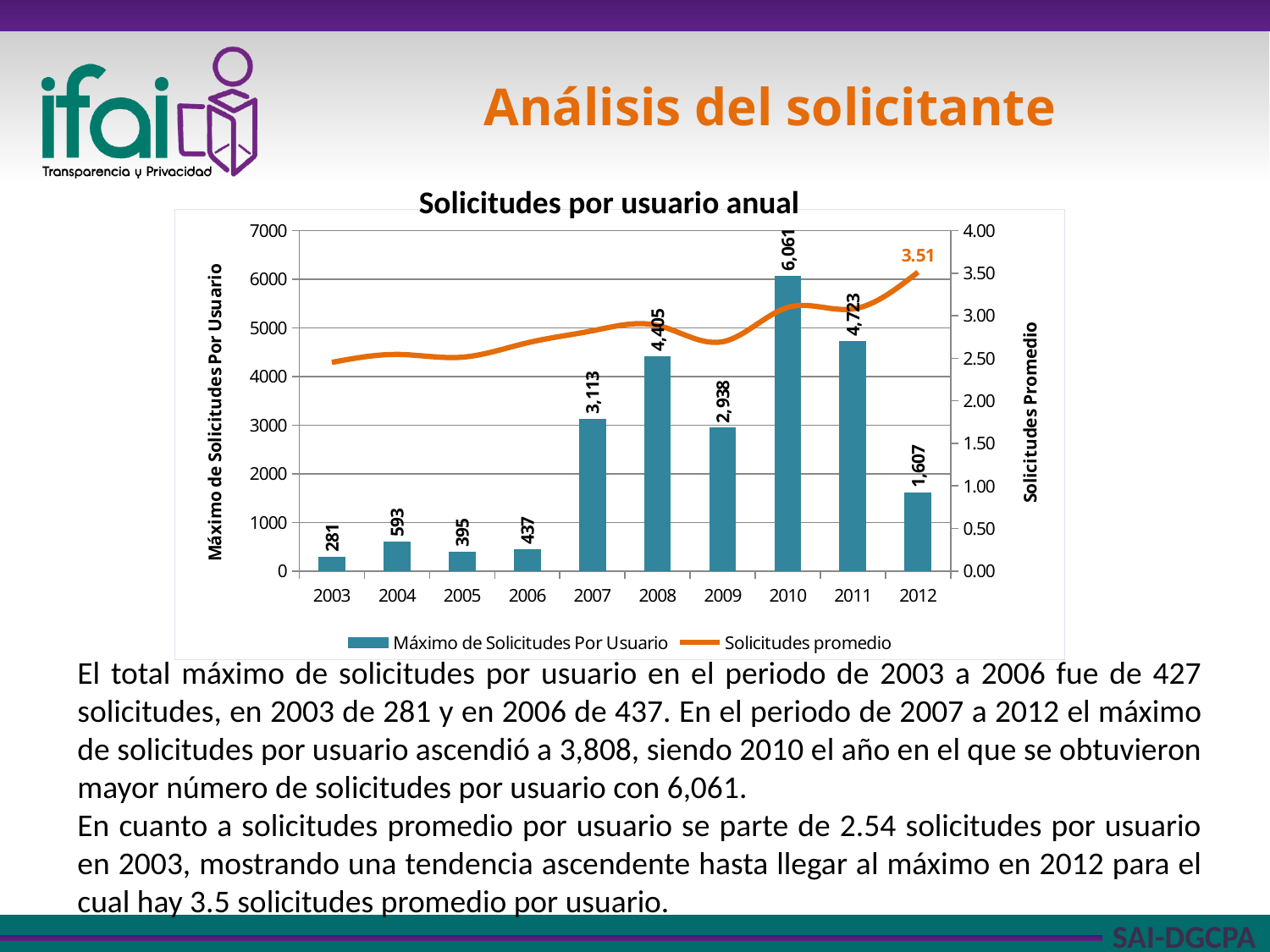
How many series does the chart legend list? 2 What is the value of Máximo de Solicitudes Por Usuario for 2010? 6,061 How many years are shown on the x axis of the chart? 10 What is the difference between the Máximo de Solicitudes Por Usuario for 2010 and 2011? 1,338 What is the Solicitudes promedio value labelled for 2012? 3.51 What is the value of Máximo de Solicitudes Por Usuario for 2012? 1,607 Is the Solicitudes promedio value for 2003 greater or less than 3.00? less Which year has the highest Máximo de Solicitudes Por Usuario? 2010 Which year has the lowest Máximo de Solicitudes Por Usuario? 2003 Which year has a larger Máximo de Solicitudes Por Usuario, 2008 or 2009? 2008 What is the title of the chart? Solicitudes por usuario anual What is the value of Máximo de Solicitudes Por Usuario for 2003? 281